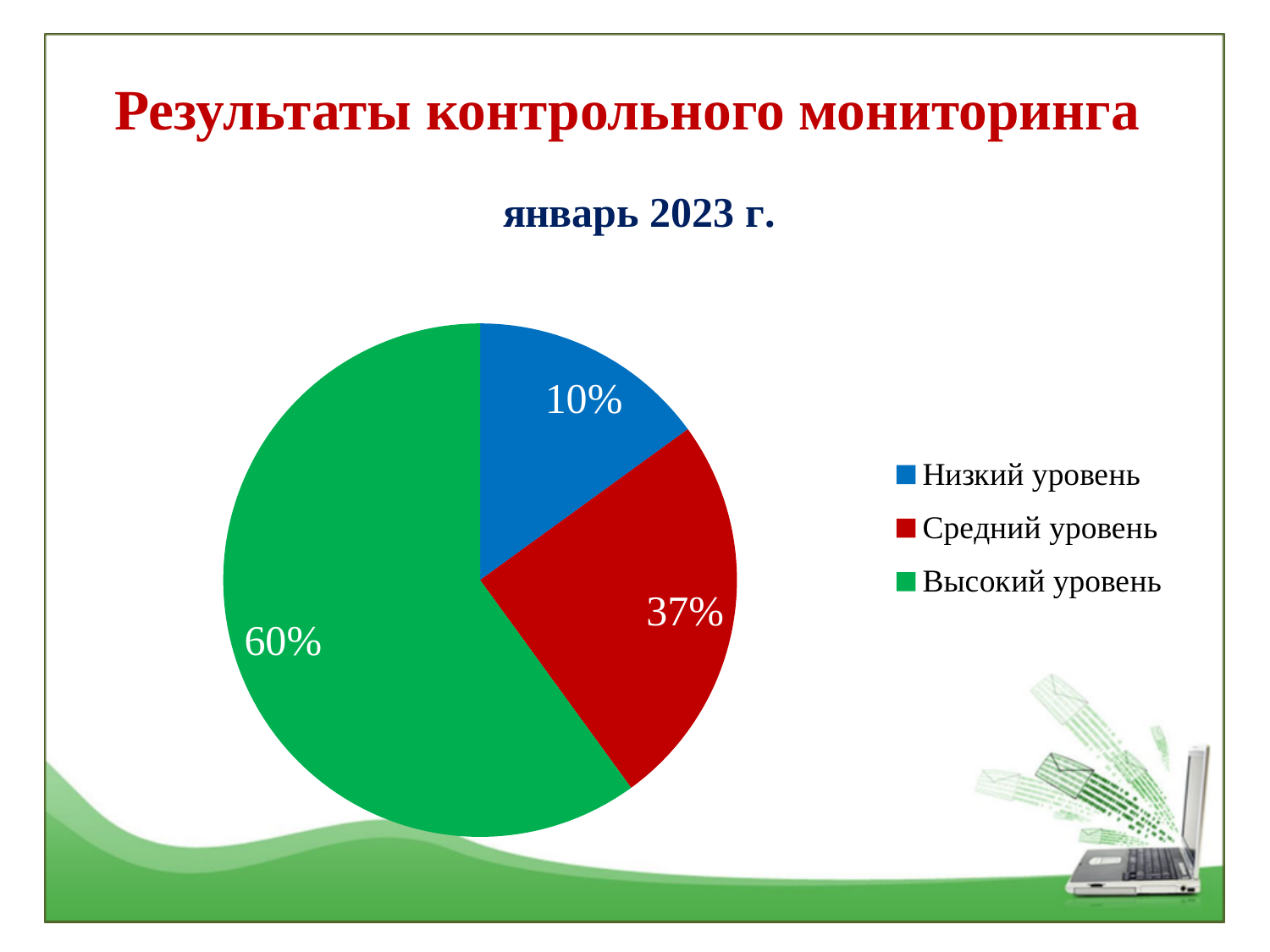
What is the difference in percentage points between Высокий уровень and Средний уровень? 23 What share of the pie does Низкий уровень have? 10% What colour is the slice for Высокий уровень? green Which category has the largest slice of the pie? Высокий уровень What share of the pie does Средний уровень have? 37% Which is larger, the slice for Средний уровень or the slice for Низкий уровень? Средний уровень What share of the pie does Высокий уровень have? 60% How many entries does the legend list? 3 Which category has the smallest slice of the pie? Низкий уровень What kind of chart is shown on the slide? pie chart How many categories does the pie chart show? 3 What is the difference in percentage points between Средний уровень and Низкий уровень? 27